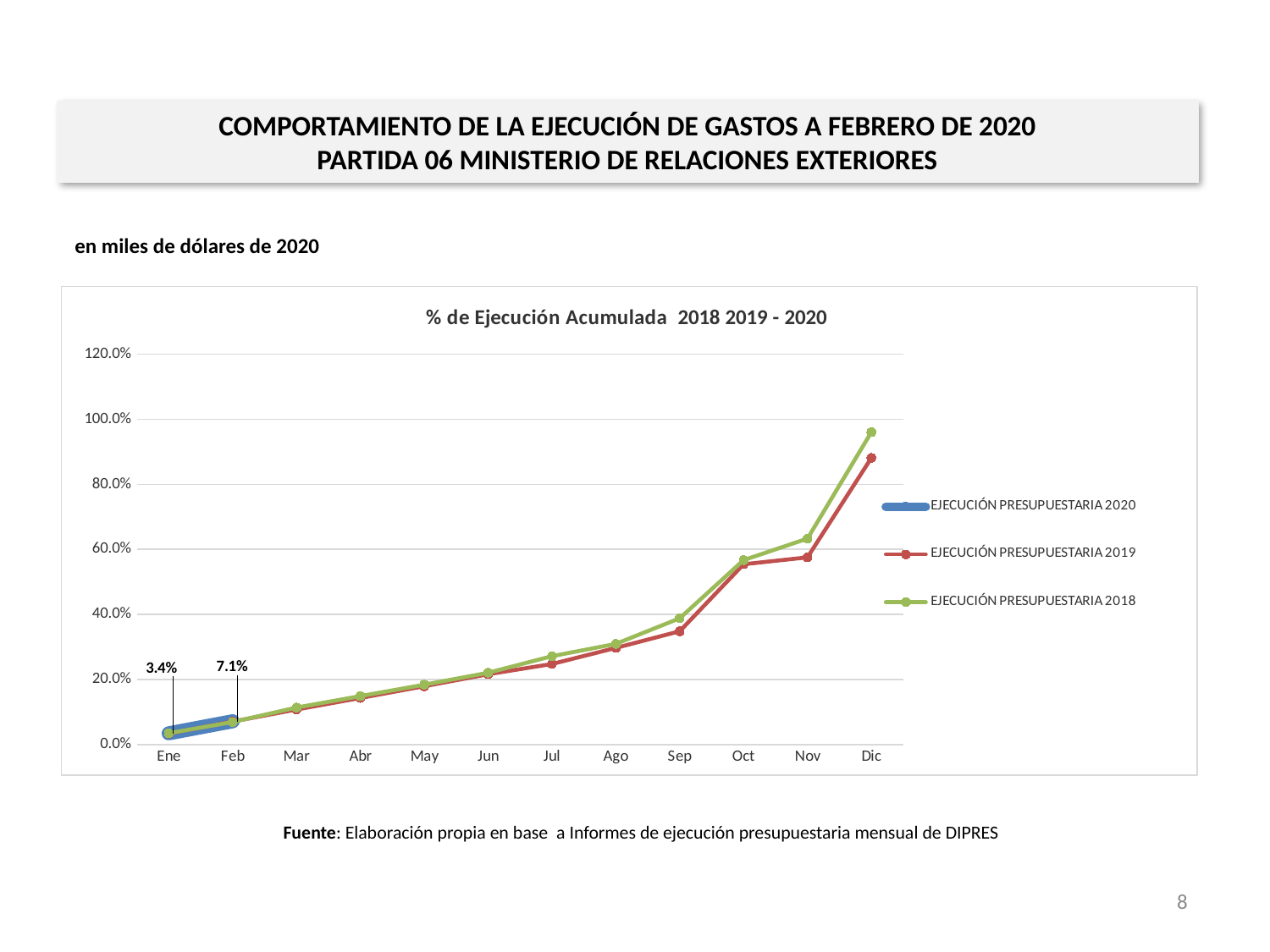
What is the value for EJECUCIÓN PRESUPUESTARIA 2020 in Feb? 7.1% What is the title of the chart? % de Ejecución Acumulada 2018 2019 - 2020 What kind of chart is shown on the slide? line chart Is the value for EJECUCIÓN PRESUPUESTARIA 2019 in Dic greater or less than 100.0%? less Is the value for EJECUCIÓN PRESUPUESTARIA 2018 in Dic greater or less than 80.0%? greater What is the value for EJECUCIÓN PRESUPUESTARIA 2020 in Ene? 3.4% By how much did EJECUCIÓN PRESUPUESTARIA 2020 increase from Ene to Feb? 3.7% In which month does the EJECUCIÓN PRESUPUESTARIA 2018 series reach its highest value? Dic How many series does the legend list? 3 In Dic, which series is higher: EJECUCIÓN PRESUPUESTARIA 2018 or EJECUCIÓN PRESUPUESTARIA 2019? EJECUCIÓN PRESUPUESTARIA 2018 How many months are shown on the x axis? 12 Does the EJECUCIÓN PRESUPUESTARIA 2018 series rise or fall from Ene to Dic? rise